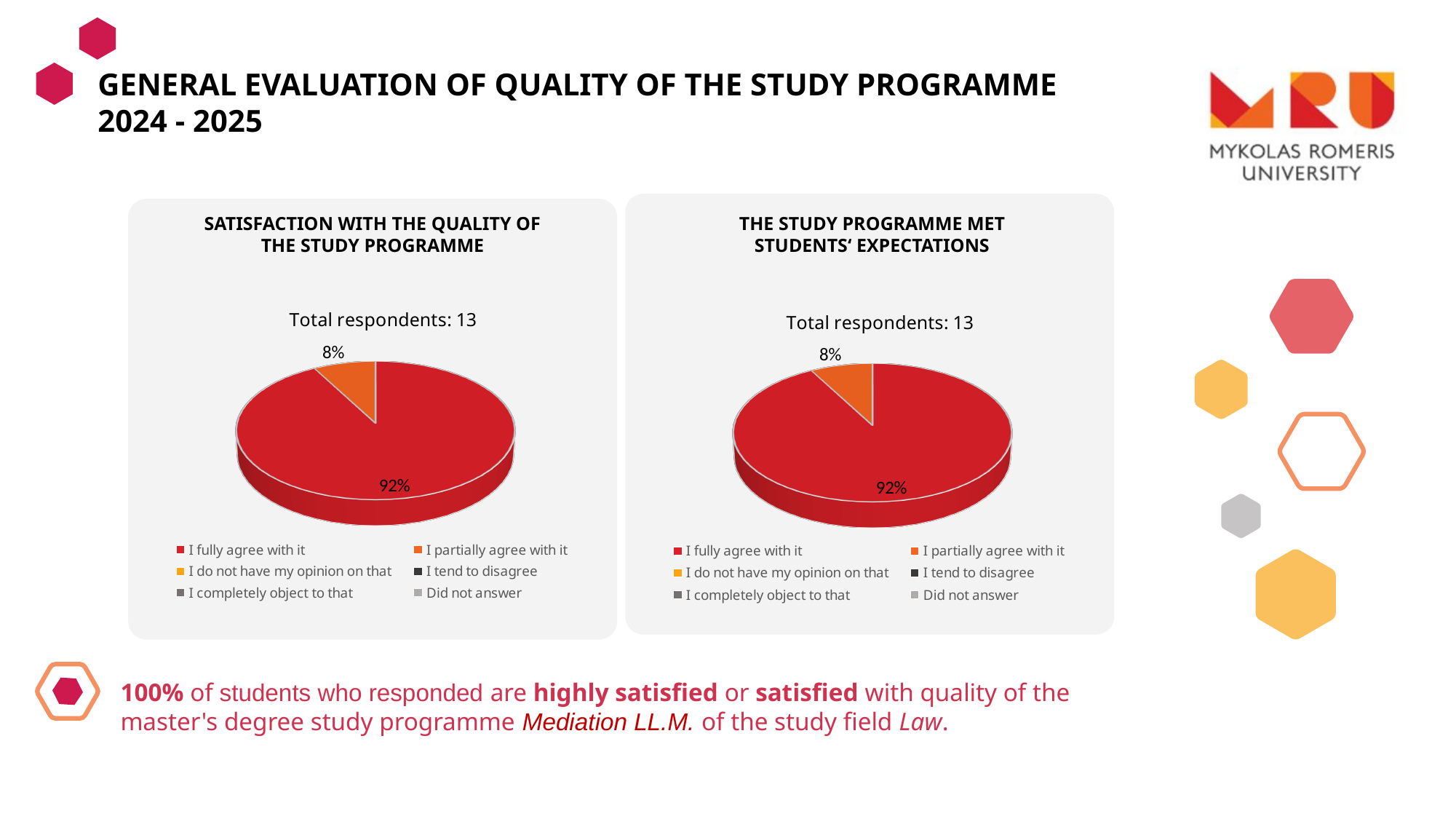
In the 'Satisfaction with the quality of the study programme' chart, which response has the largest slice? I fully agree with it In the 'The study programme met students' expectations' chart, what share of respondents fully agree with it? 92% In the 'Satisfaction with the quality of the study programme' chart, what share of respondents partially agree with it? 8% In the 'The study programme met students' expectations' chart, which is larger: 'I fully agree with it' or 'I partially agree with it'? I fully agree with it In the 'The study programme met students' expectations' chart, what share of respondents partially agree with it? 8% How many entries does the legend of the 'The study programme met students' expectations' chart list? 6 What kind of chart is used in the 'Satisfaction with the quality of the study programme' panel? Pie chart In the 'Satisfaction with the quality of the study programme' chart, what share of respondents fully agree with it? 92% In the 'Satisfaction with the quality of the study programme' chart, what colour is the 'I fully agree with it' slice? Red In the 'Satisfaction with the quality of the study programme' chart, what is the difference in percentage points between the 'I fully agree with it' and 'I partially agree with it' slices? 84 In the 'The study programme met students' expectations' chart, which response has the smallest visible slice? I partially agree with it How many total respondents are reported for the 'Satisfaction with the quality of the study programme' chart? 13